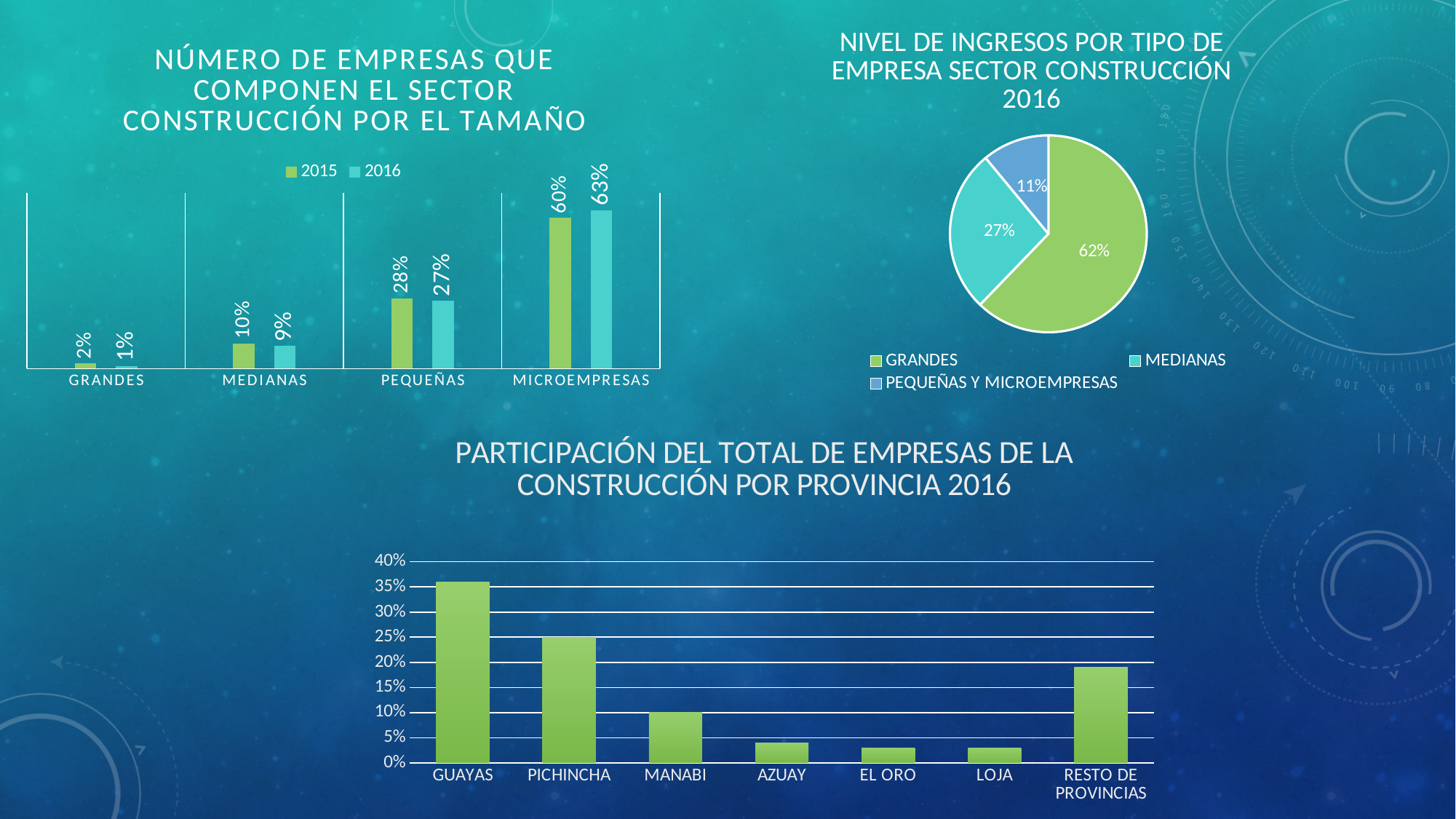
In the chart 'Número de empresas que componen el sector construcción por el tamaño', what is the difference between the 2015 and 2016 values for MEDIANAS? 1% In the pie chart 'Nivel de ingresos por tipo de empresa sector construcción 2016', what share do GRANDES have? 62% In the chart 'Participación del total de empresas de la construcción por provincia 2016', which province has the highest value? GUAYAS In the chart 'Número de empresas que componen el sector construcción por el tamaño', what is the 2015 value for PEQUEÑAS? 28% In the pie chart 'Nivel de ingresos por tipo de empresa sector construcción 2016', how many slices are there? 3 What kind of chart is 'Participación del total de empresas de la construcción por provincia 2016'? bar chart In the pie chart 'Nivel de ingresos por tipo de empresa sector construcción 2016', what share do PEQUEÑAS Y MICROEMPRESAS have? 11% In the chart 'Participación del total de empresas de la construcción por provincia 2016', is the value for GUAYAS greater or less than 30%? greater In the chart 'Número de empresas que componen el sector construcción por el tamaño', how many series does the legend list? 2 In the chart 'Número de empresas que componen el sector construcción por el tamaño', what is the 2016 value for MICROEMPRESAS? 63% In the chart 'Número de empresas que componen el sector construcción por el tamaño', which category has the lowest 2016 value? GRANDES In the chart 'Participación del total de empresas de la construcción por provincia 2016', which is larger, the value for PICHINCHA or the value for RESTO DE PROVINCIAS? PICHINCHA